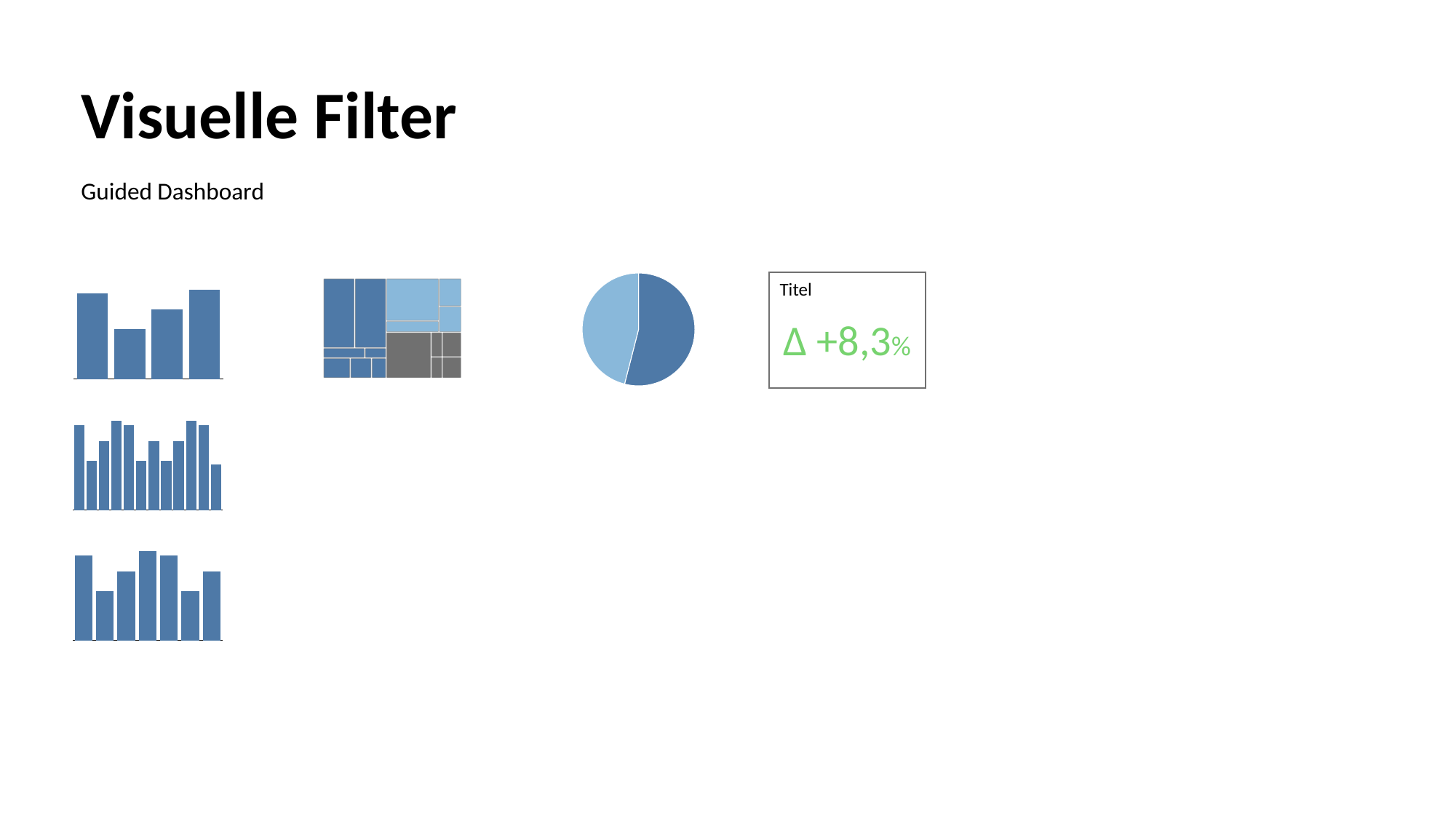
How many bars does the bottom-left bar chart have? 7 How many slices does the pie chart have? 2 How many bars does the top-left bar chart have? 4 In the top-left bar chart, which bar is the shortest? the second bar What kind of chart is the circular chart to the right of the treemap? pie chart What kind of chart is the top-left chart on the slide? bar chart In the bottom-left bar chart, is the first bar or the second bar taller? the first bar In the top-left bar chart, which bar is the tallest? the fourth (rightmost) bar In the top-left bar chart, is the third bar or the fourth bar taller? the fourth bar What value is shown in the KPI box labelled "Titel"? Δ +8,3% In the top-left bar chart, is the first bar or the second bar taller? the first bar What colours are the two slices of the pie chart? light blue and dark blue